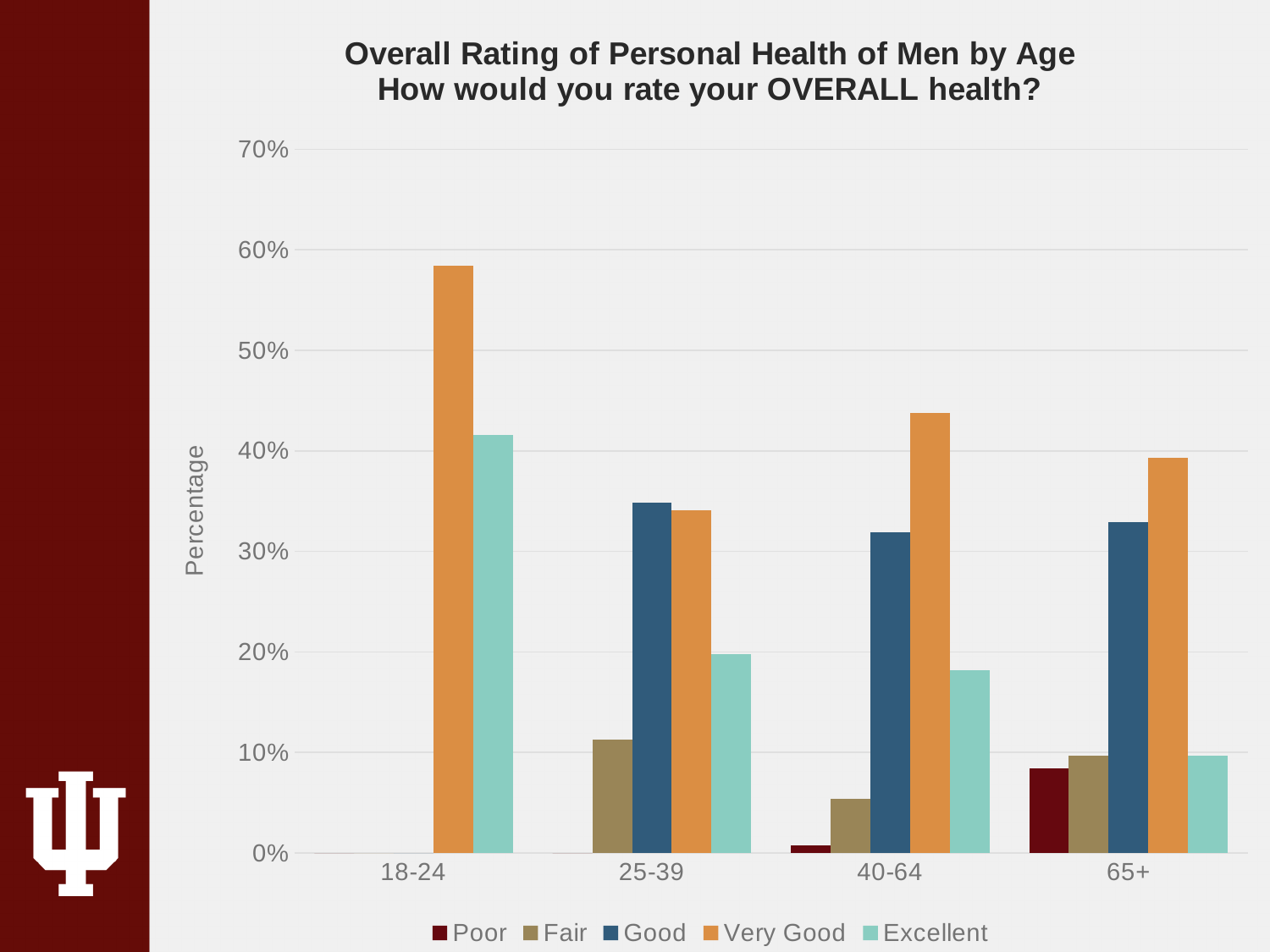
How many series does the legend list? 5 Is the Very Good value for the 18-24 age group greater or less than 50%? greater Is the Good value for the 25-39 age group greater or less than 30%? greater Which age group has the highest Very Good rating? 18-24 Do the Poor values rise or fall as age increases from 18-24 to 65+? rise Which age group has the highest Poor rating? 65+ Do the Excellent values rise or fall as age increases from 18-24 to 65+? fall For the 40-64 age group, which is larger: Very Good or Good? Very Good Is the Excellent value for the 18-24 age group greater or less than 30%? greater What kind of chart is shown on the slide? bar chart How many age groups are shown on the x axis? 4 What is the label on the y axis? Percentage